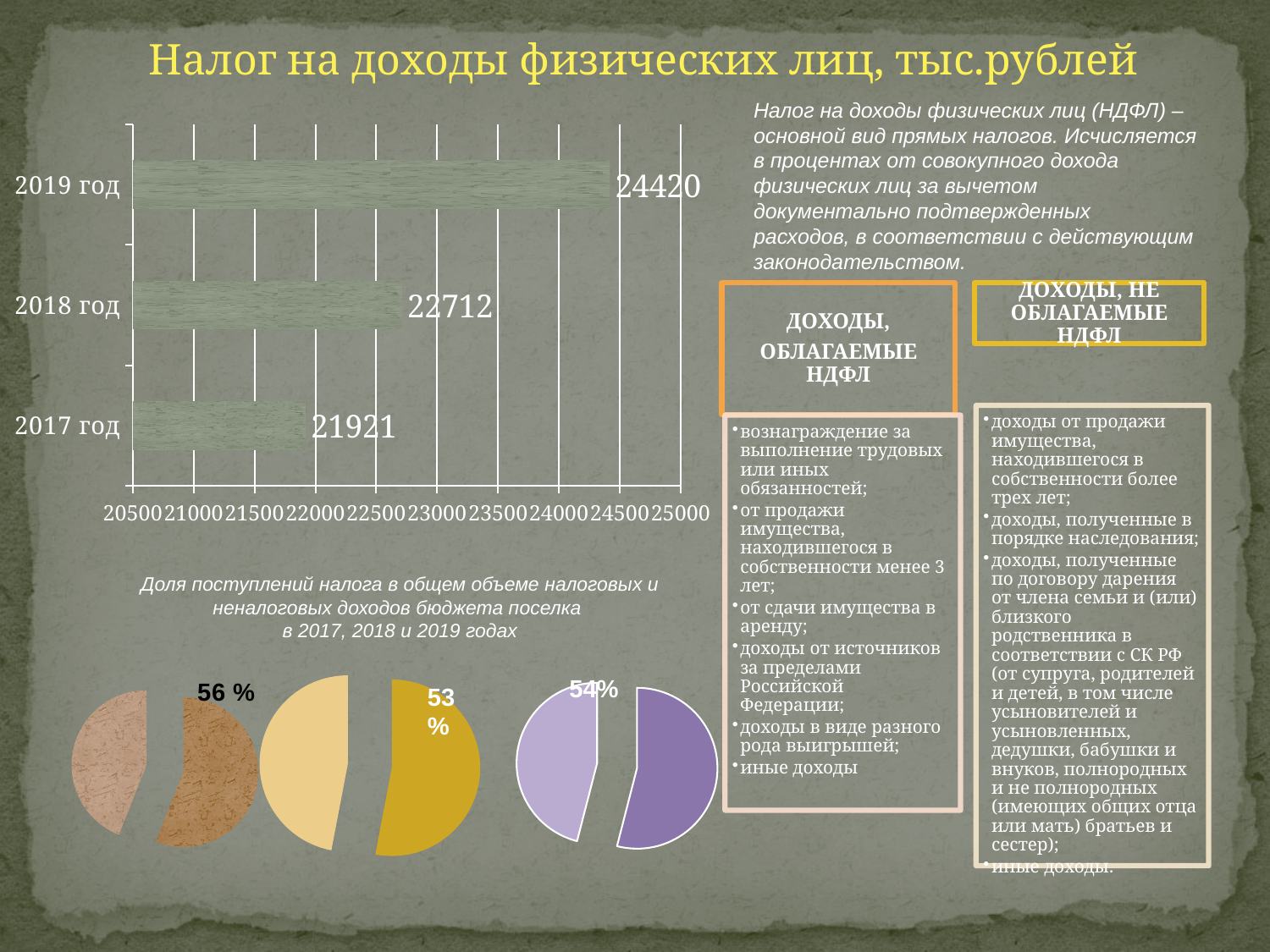
In the bar chart, which year has the highest value? 2019 год In the bar chart, what is the difference between the values for 2018 год and 2017 год? 791 In the bar chart, what is the value for 2018 год? 22712 In the bar chart, what is the difference between the values for 2019 год and 2018 год? 1708 What kind of chart shows the values for 2017, 2018 and 2019 год? bar chart In the bar chart, what is the value for 2017 год? 21921 In the bar chart, is the value for 2019 год greater or less than 24000? greater How many years are shown in the bar chart? 3 In the bar chart, which is larger: the value for 2018 год or 2017 год? 2018 год In the bar chart, do the values rise or fall from 2017 год to 2019 год? rise In the bar chart, what is the value for 2019 год? 24420 In the bar chart, which year has the lowest value? 2017 год